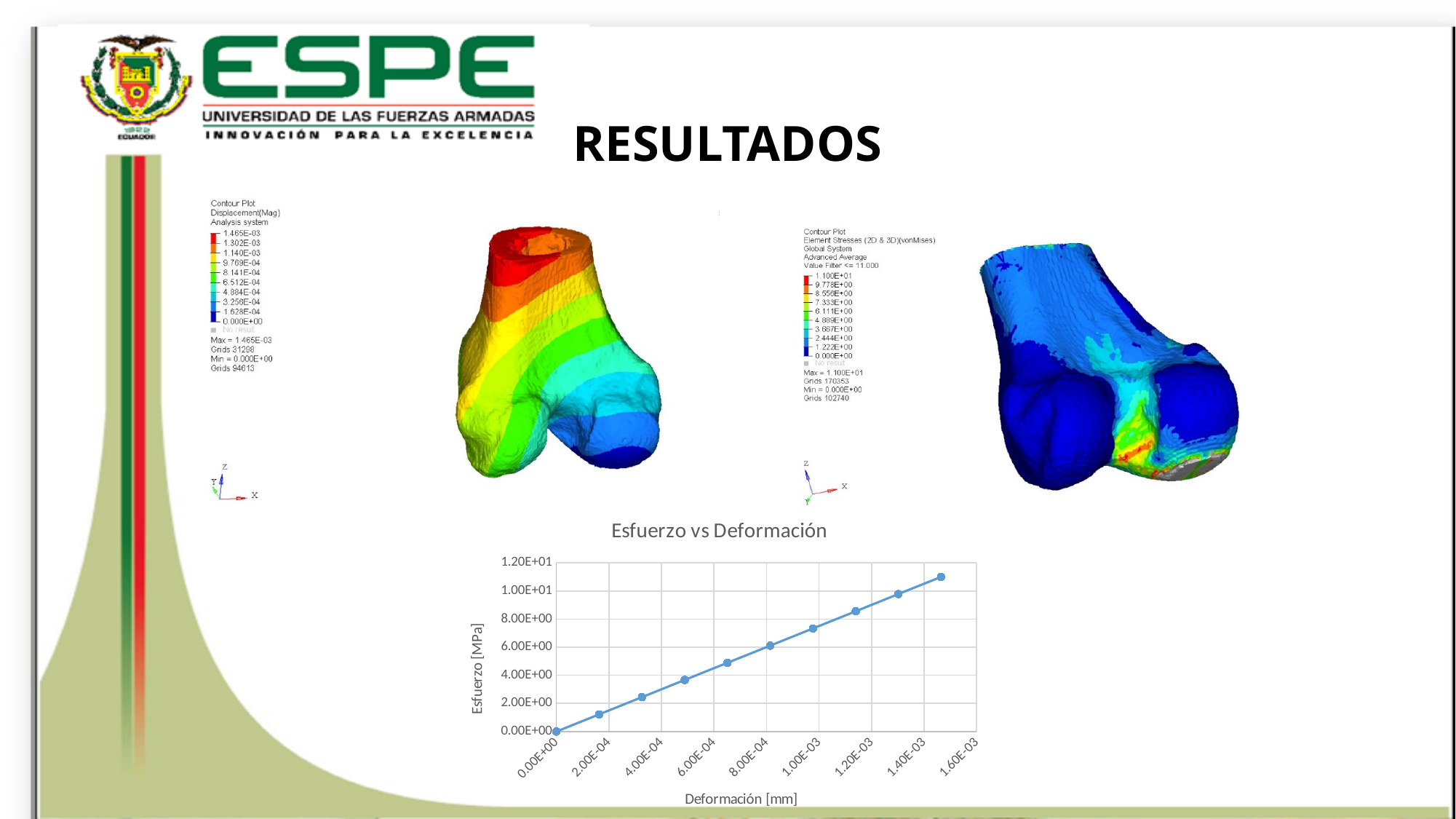
In the "Esfuerzo vs Deformación" chart, do the values rise or fall as Deformación increases? rise In the "Esfuerzo vs Deformación" chart, is the Esfuerzo value of the second point greater or less than 2.00E+00? less In the "Esfuerzo vs Deformación" chart, what is the Esfuerzo value at Deformación 0.00E+00? 0.00E+00 What kind of chart is "Esfuerzo vs Deformación"? line chart In the "Esfuerzo vs Deformación" chart, what is the highest tick value shown on the y axis? 1.20E+01 What is the label of the y axis in the "Esfuerzo vs Deformación" chart? Esfuerzo [MPa] In the "Esfuerzo vs Deformación" chart, which point has the highest Esfuerzo value, the leftmost or the rightmost? the rightmost What is the title of the chart at the bottom of the slide? Esfuerzo vs Deformación In the "Esfuerzo vs Deformación" chart, is the Esfuerzo value of the point at about 8.00E-04 Deformación greater or less than 8.00E+00? less How many data points are plotted in the "Esfuerzo vs Deformación" chart? 10 In the "Esfuerzo vs Deformación" chart, is the Esfuerzo value of the last (rightmost) point greater or less than 1.00E+01? greater